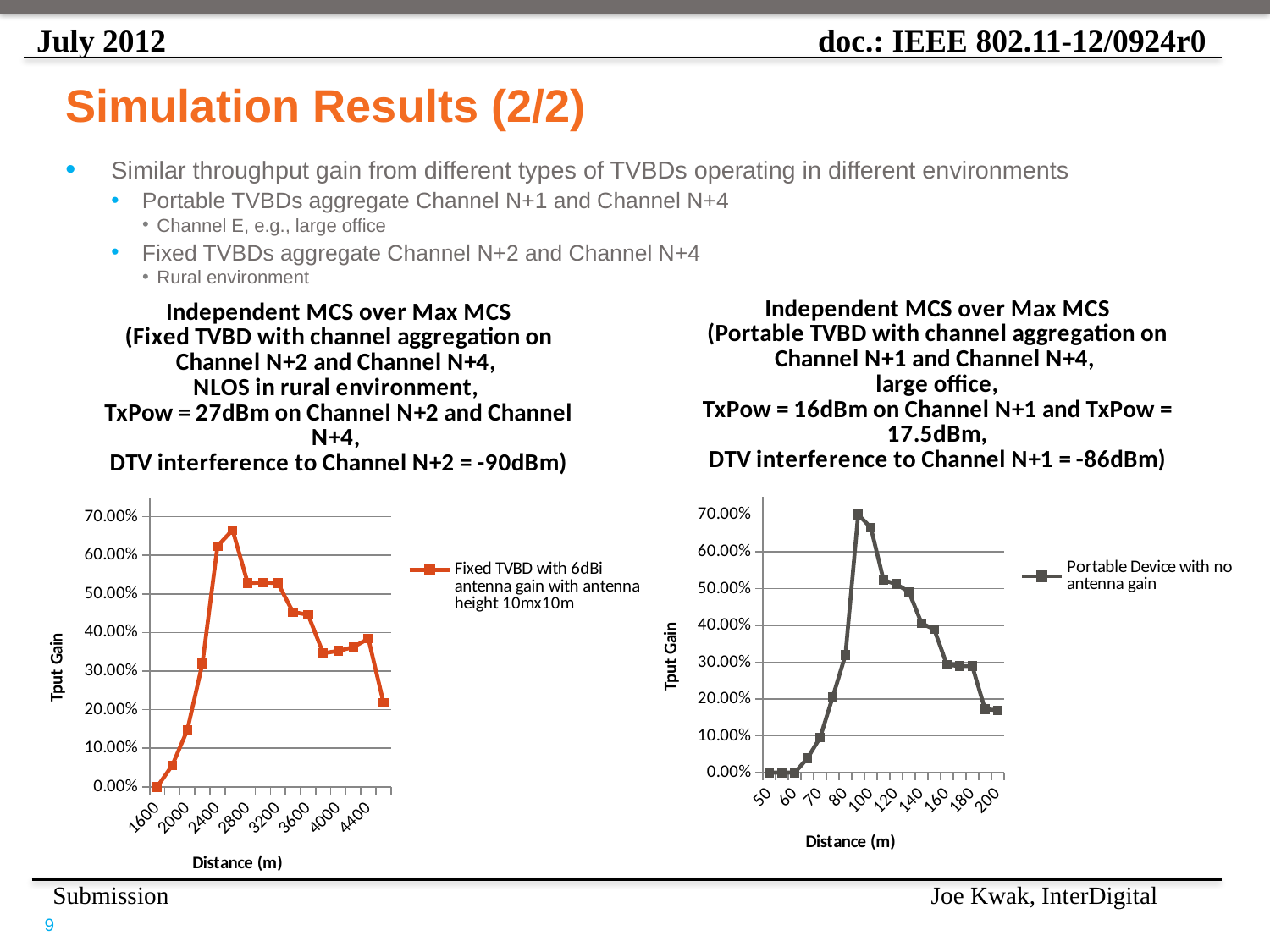
In the left chart (Fixed TVBD), do the values rise or fall as distance increases from 1600 to 2400? rise In the left chart (Fixed TVBD), is the value at distance 1600 greater or less than 10.00%? less In the left chart (Fixed TVBD), is the value at distance 2400 greater or less than 50.00%? greater In the left chart (Fixed TVBD), is the value at distance 2400 larger or smaller than the value at distance 2000? larger How many series does the legend of the right chart (Portable TVBD with channel aggregation on Channel N+1 and Channel N+4) list? 1 What kind of chart is the left chart (Fixed TVBD with channel aggregation on Channel N+2 and Channel N+4)? Line chart In the right chart (Portable TVBD), is the value at distance 50 greater or less than 10.00%? less In the right chart (Portable TVBD), what is the label of the x axis? Distance (m) In the right chart (Portable TVBD), do the values rise or fall as distance increases from 100 to 200? fall In the left chart (Fixed TVBD), what is the legend entry for the plotted series? Fixed TVBD with 6dBi antenna gain with antenna height 10mx10m